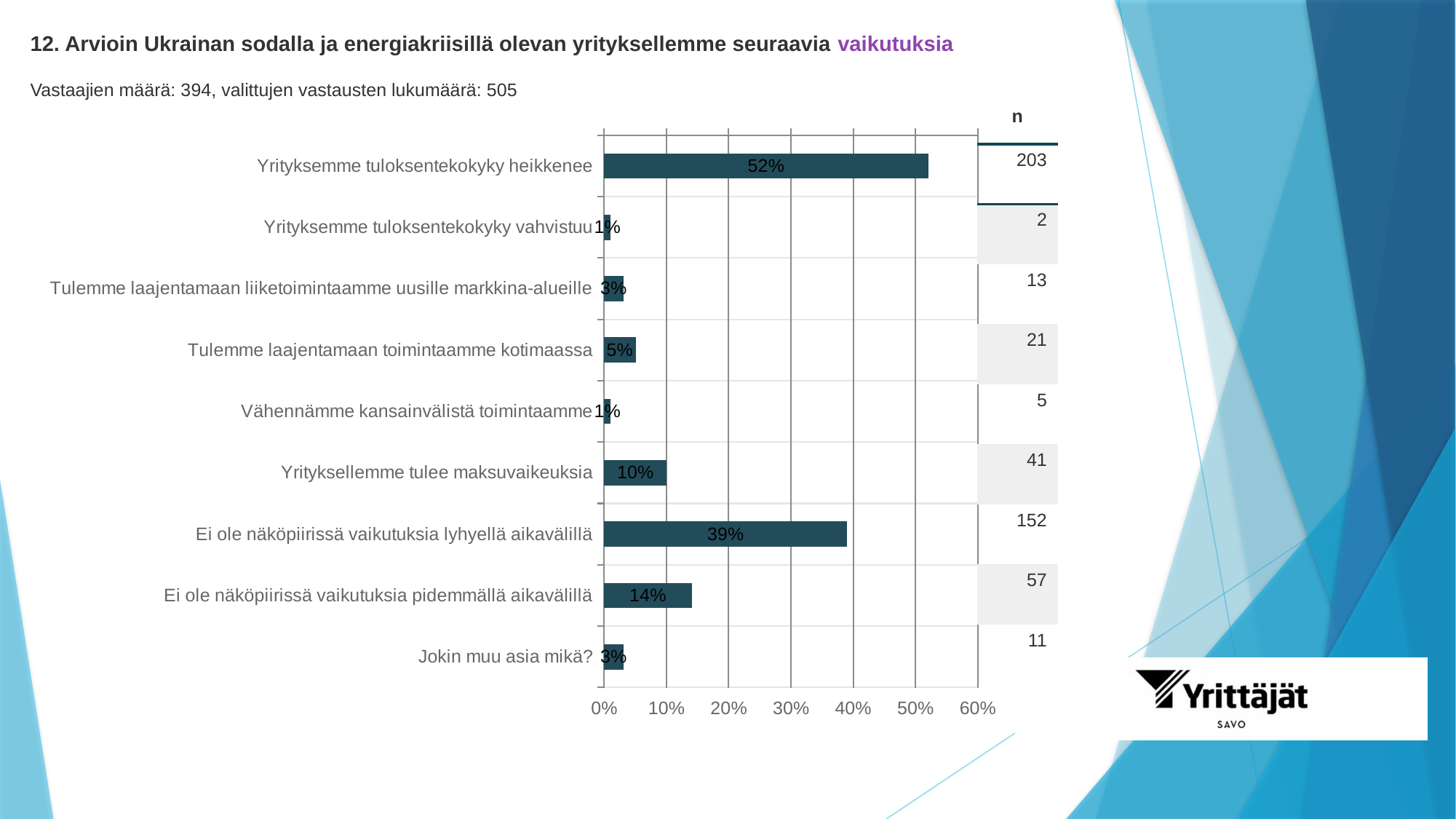
What is the difference in percentage points between "Yrityksemme tuloksentekokyky heikkenee" and "Ei ole näköpiirissä vaikutuksia lyhyellä aikavälillä"? 13% What percentage is shown for "Yrityksellemme tulee maksuvaikeuksia"? 10% How many categories are shown in the chart? 9 What percentage is shown for "Ei ole näköpiirissä vaikutuksia lyhyellä aikavälillä"? 39% What is the n value for "Yrityksemme tuloksentekokyky heikkenee"? 203 What percentage is shown for "Yrityksemme tuloksentekokyky heikkenee"? 52% What is the n value for "Ei ole näköpiirissä vaikutuksia pidemmällä aikavälillä"? 57 What kind of chart is shown on the slide? bar chart Is the value for "Ei ole näköpiirissä vaikutuksia pidemmällä aikavälillä" greater or less than 20%? less What is the highest value shown on the percentage axis? 60% Which category has the highest percentage? Yrityksemme tuloksentekokyky heikkenee Which is larger: the percentage for "Tulemme laajentamaan toimintaamme kotimaassa" or for "Tulemme laajentamaan liiketoimintaamme uusille markkina-alueille"? Tulemme laajentamaan toimintaamme kotimaassa